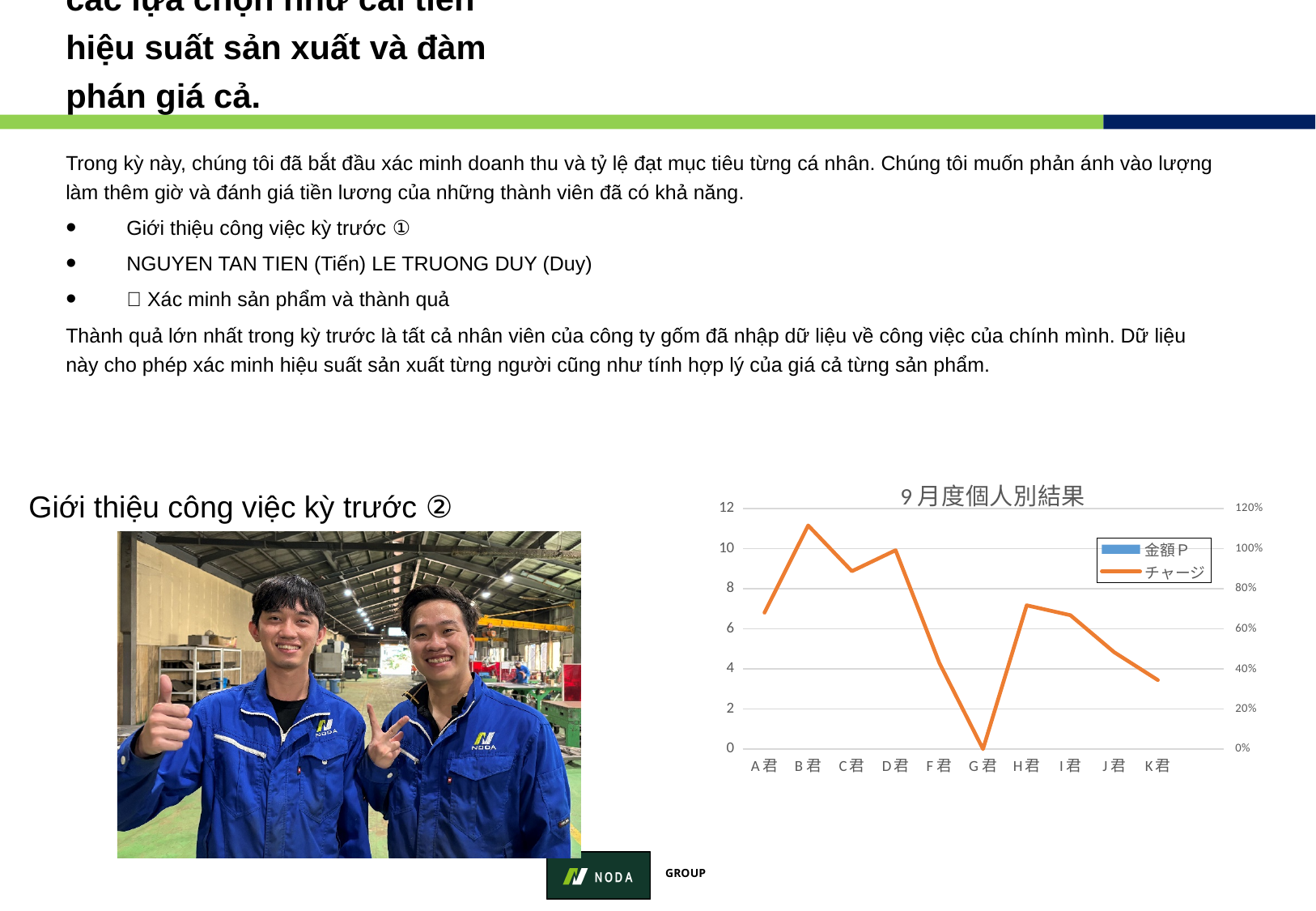
What is the title of the chart on the slide? 9月度個人別結果 Does the チャージ line rise or fall from H君 to K君? fall Which has the larger チャージ value, H君 or K君? H君 Is the チャージ value for C君 greater or less than 8 on the left axis? greater Is the チャージ value for K君 greater or less than 4 on the left axis? less Is the チャージ value for B君 greater or less than 10 on the left axis? greater How many series does the chart legend list? 2 How many categories are shown on the x axis of the chart? 10 Which has the larger チャージ value, B君 or C君? B君 Which category has the highest value on the チャージ line? B君 Which category has the lowest value on the チャージ line? G君 What kind of chart is shown on the slide? line chart